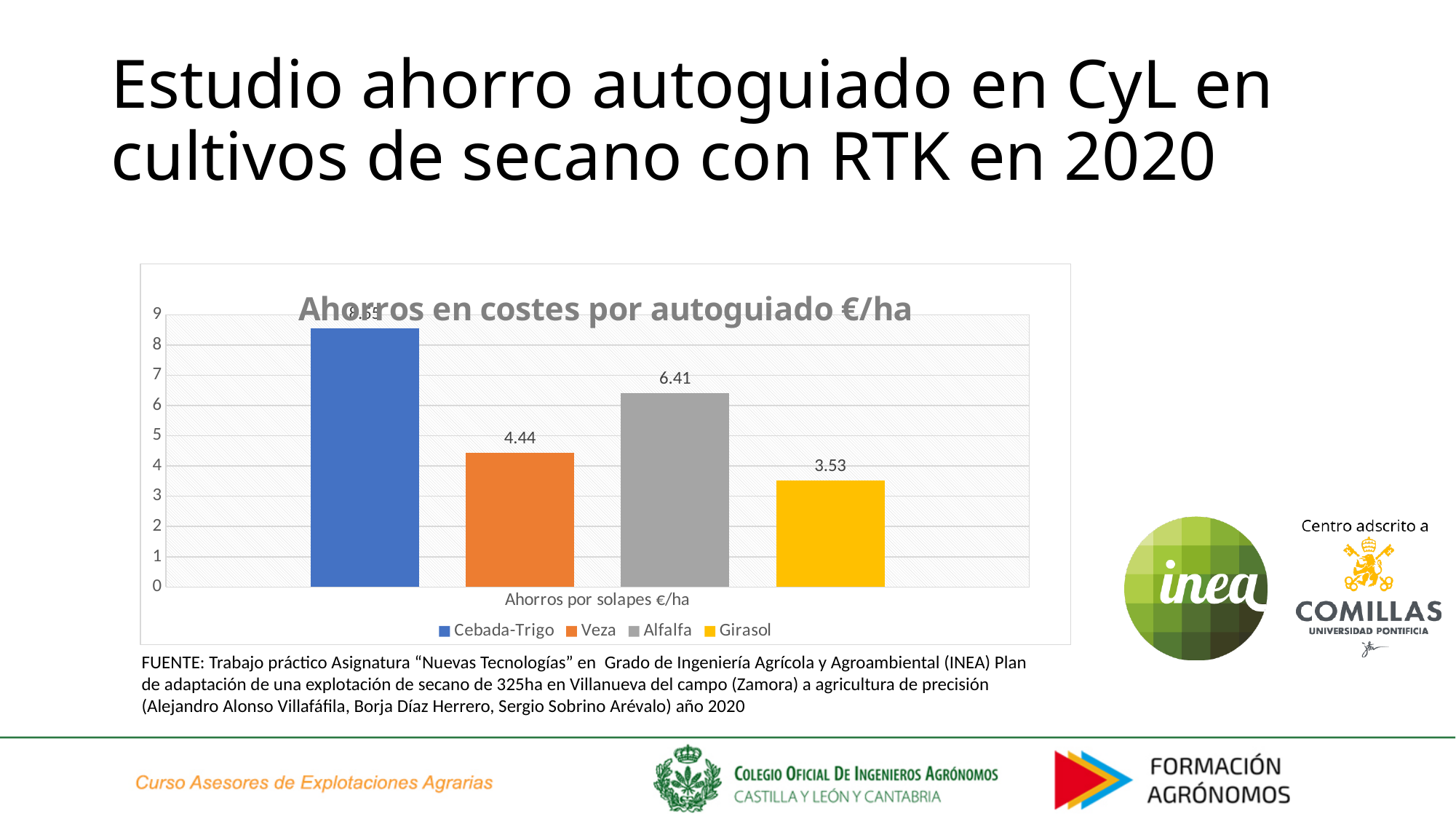
Which is larger, the value for Alfalfa or the value for Veza? Alfalfa What kind of chart is shown on the slide? Bar chart What is the value for Alfalfa in the chart? 6.41 Which series has the highest savings in the chart? Cebada-Trigo What is the title of the chart? Ahorros en costes por autoguiado €/ha Which series has the lowest savings in the chart? Girasol What is the difference between the values for Alfalfa and Veza? 1.97 What is the value for Girasol in the chart? 3.53 What is the difference between the values for Veza and Girasol? 0.91 Is the value for Cebada-Trigo greater or less than 8? greater What is the value for Veza in the chart? 4.44 How many series does the legend list? 4